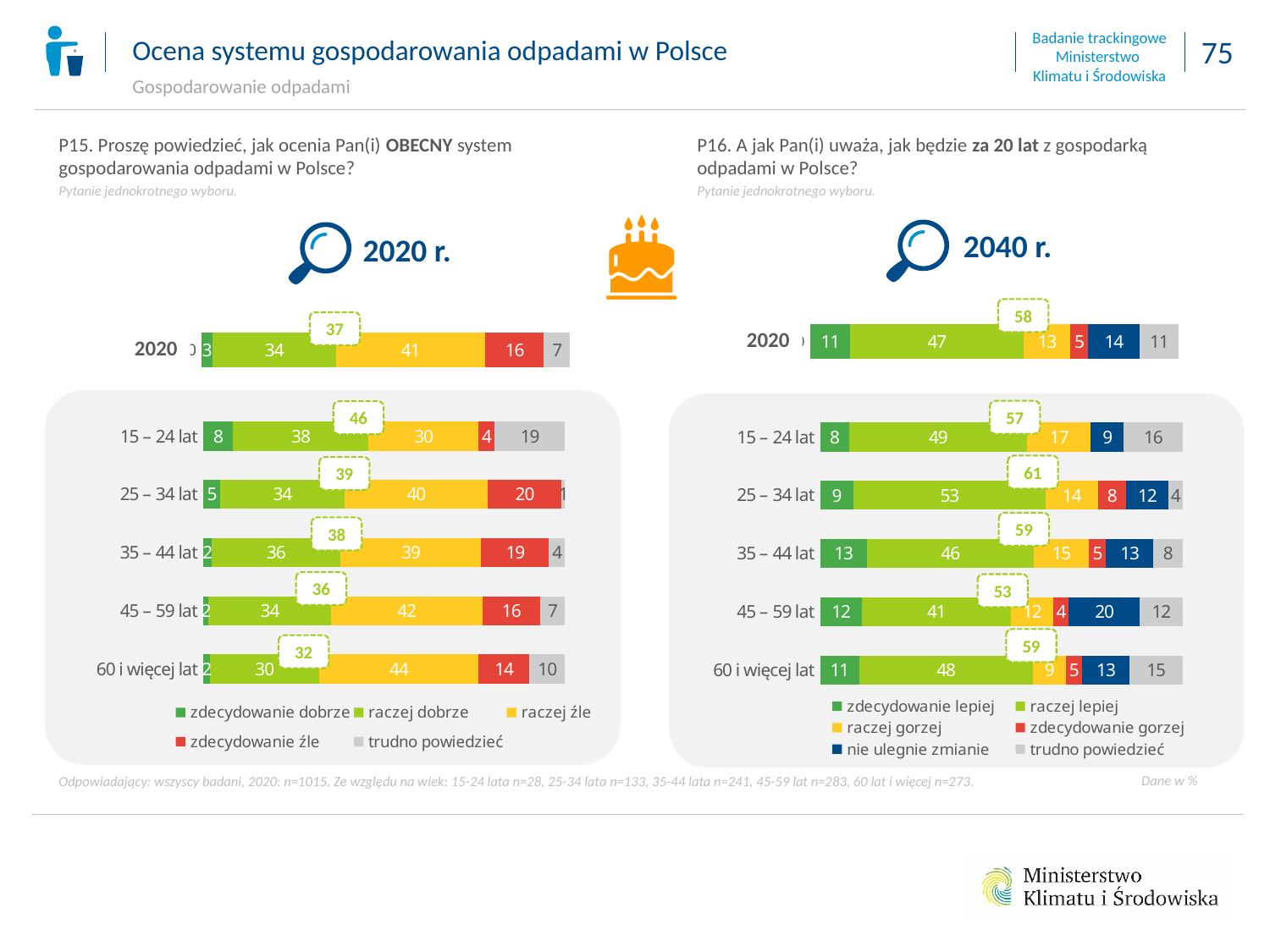
In the P15 (2020 r.) age-group chart on the left, which age group has the highest 'trudno powiedzieć' value? 15 – 24 lat In the P16 (2040 r.) age-group chart on the right, which age group has the highest 'raczej lepiej' value? 25 – 34 lat How many age groups are shown in the P15 (2020 r.) age-group chart on the left? 5 In the P16 (2040 r.) age-group chart on the right, is the 'raczej lepiej' value larger for 35 – 44 lat or for 45 – 59 lat? 35 – 44 lat How many series does the legend of the P16 (2040 r.) chart on the right list? 6 In the P16 (2040 r.) age-group chart on the right, what is the value of 'nie ulegnie zmianie' for 45 – 59 lat? 20 In the P15 (2020 r.) age-group chart on the left, what is the value of 'raczej źle' for 60 i więcej lat? 44 In the P16 (2040 r.) total bar for 2020 on the right, what is the value of 'raczej lepiej'? 47 In the P15 (2020 r.) total bar for 2020 on the left, what is the value of 'raczej źle'? 41 In the P15 (2020 r.) age-group chart on the left, what is the difference between the 'raczej dobrze' values for 15 – 24 lat and 60 i więcej lat? 8 In the P15 (2020 r.) age-group chart on the left, what is the value of 'zdecydowanie źle' for 25 – 34 lat? 20 What type of chart is used for the P15 (2020 r.) age-group data on the left? Stacked bar chart